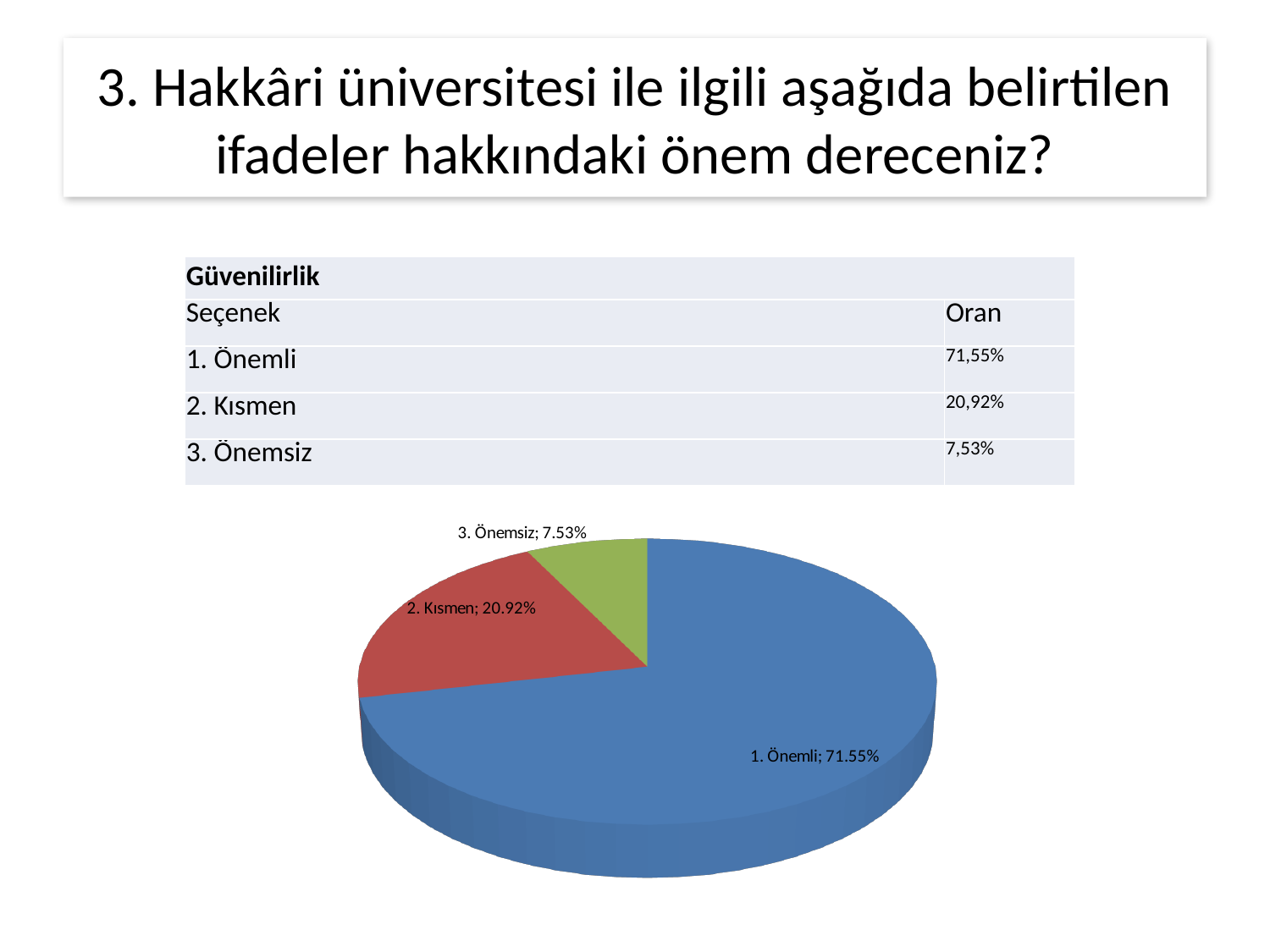
Which slice of the pie chart is the largest? 1. Önemli What is the difference between the values for "2. Kısmen" and "3. Önemsiz" in the pie chart? 13.39% How many slices does the pie chart have? 3 What is the difference between the values for "1. Önemli" and "2. Kısmen" in the pie chart? 50.63% What kind of chart is shown on the slide? pie chart What is the value shown for the slice "2. Kısmen" in the pie chart? 20.92% What colour is the slice for "3. Önemsiz" in the pie chart? green What colour is the slice for "1. Önemli" in the pie chart? blue Which is larger in the pie chart, "2. Kısmen" or "3. Önemsiz"? 2. Kısmen Which slice of the pie chart is the smallest? 3. Önemsiz What is the value shown for the slice "3. Önemsiz" in the pie chart? 7.53% What is the value shown for the slice "1. Önemli" in the pie chart? 71.55%